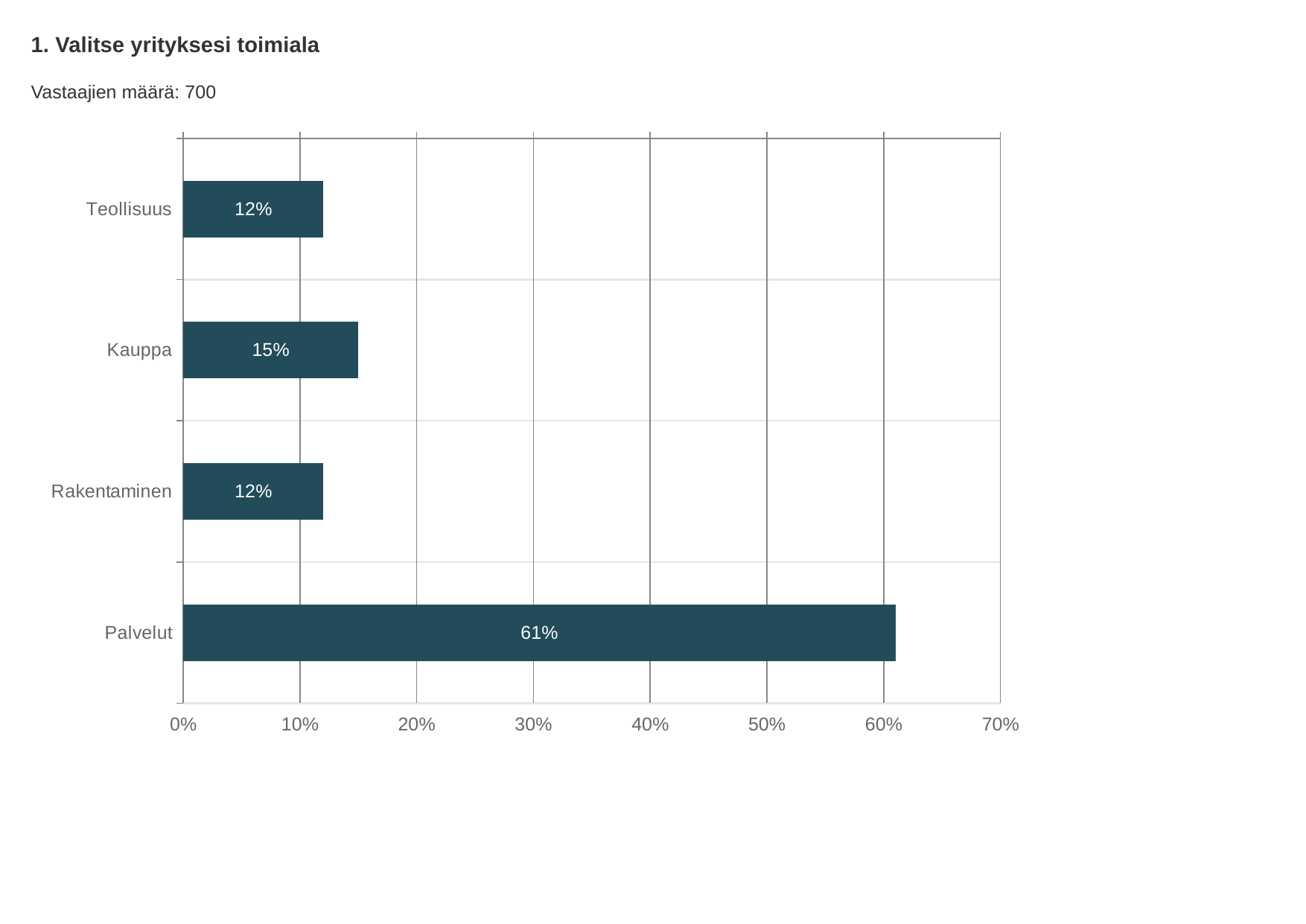
What is the value for Rakentaminen? 12% What is the title of the chart? 1. Valitse yrityksesi toimiala What is the value for Palvelut? 61% Is the value for Palvelut greater or less than 50%? greater What kind of chart is shown on the slide? bar chart Which is larger, the value for Kauppa or the value for Rakentaminen? Kauppa What is the difference between the values for Kauppa and Teollisuus? 3% How many categories are shown in the chart? 4 Which category has the highest value? Palvelut What is the difference between the values for Palvelut and Kauppa? 46% What is the value for Kauppa? 15% What is the value for Teollisuus? 12%